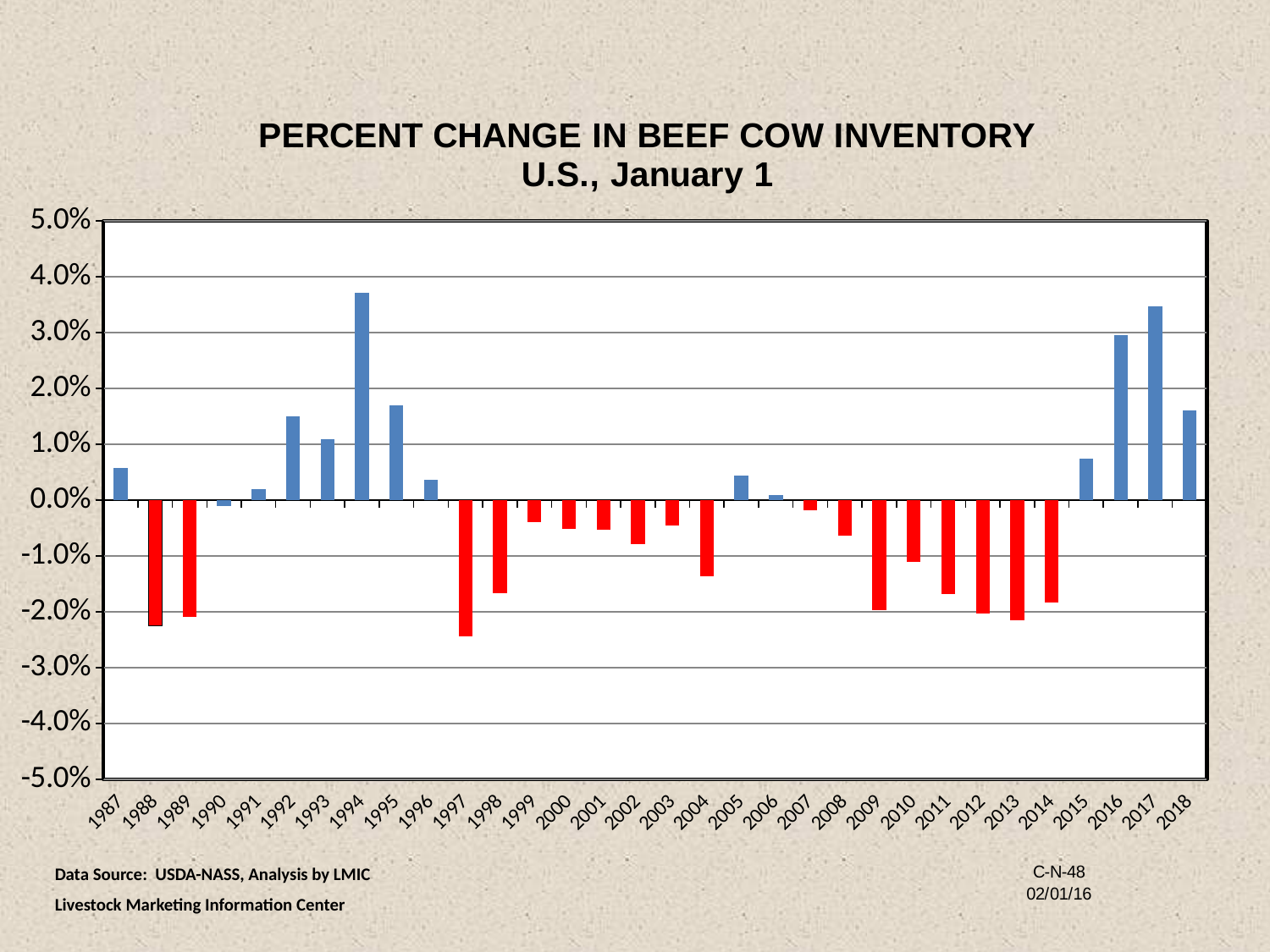
Is the value for 1994 greater or less than 3.0%? greater Is the value for 2004 greater or less than -1.0%? less What is the title of the chart? PERCENT CHANGE IN BEEF COW INVENTORY U.S., January 1 How many years are shown on the x axis of the chart? 32 Which year has the larger percent change, 1994 or 1995? 1994 Do the values rise or fall from 2015 to 2017? rise What colour are the bars for years with a negative percent change? Red Which year has the larger percent change, 2016 or 2018? 2016 Is the value for 2016 greater or less than 2.0%? greater Which year has the highest percent change in beef cow inventory? 1994 What kind of chart is shown on the slide? Bar chart